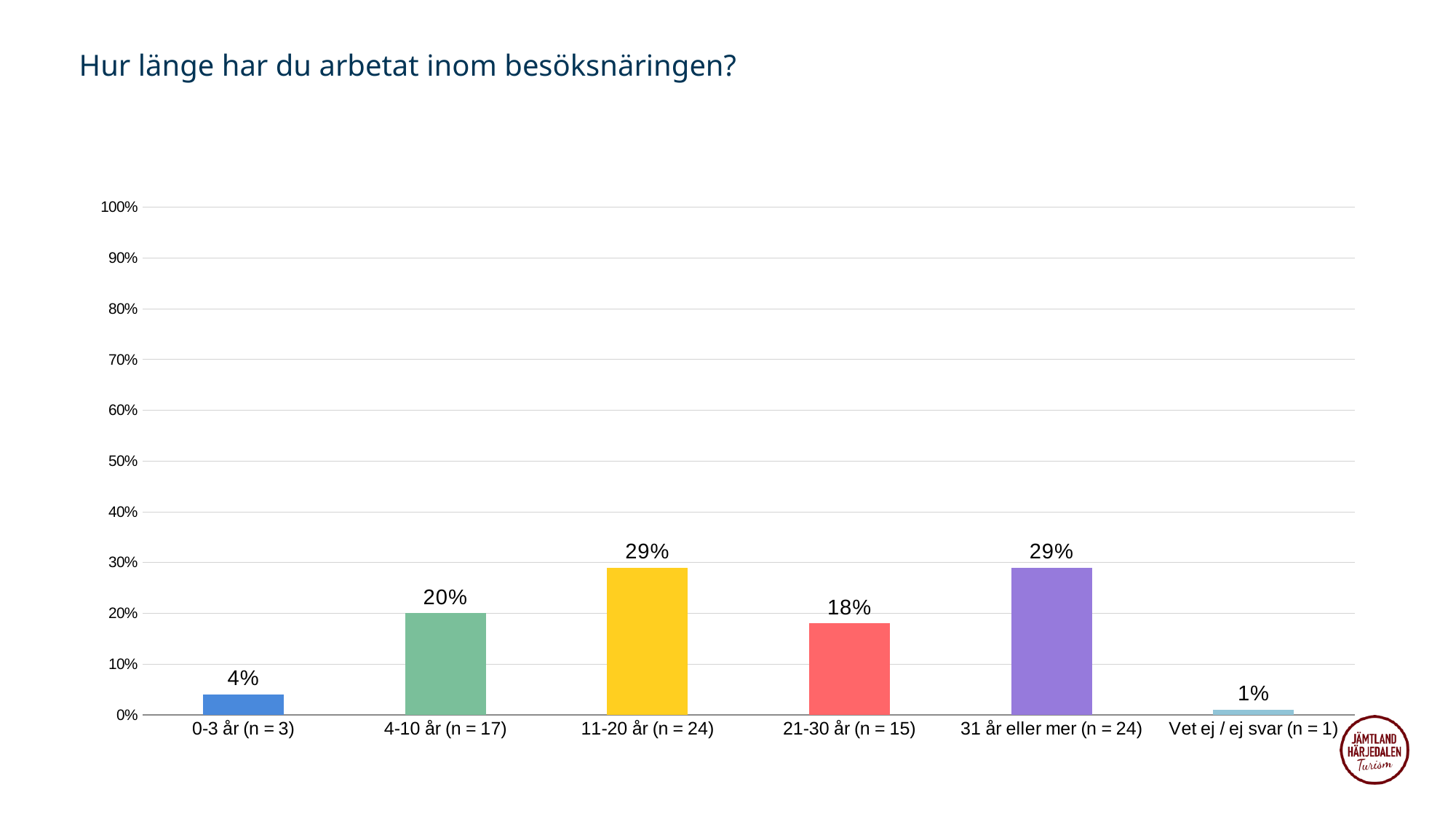
What is the value for the "21-30 år (n = 15)" category? 18% Is the value for "31 år eller mer (n = 24)" greater or less than 20%? greater What is the difference between the values for "4-10 år (n = 17)" and "21-30 år (n = 15)"? 2% Which category has the lowest value? Vet ej / ej svar (n = 1) How many categories are shown on the x axis? 6 What is the value for the "0-3 år (n = 3)" category? 4% What is the value for the "Vet ej / ej svar (n = 1)" category? 1% What is the difference between the values for "11-20 år (n = 24)" and "0-3 år (n = 3)"? 25% What kind of chart is shown on the slide? Bar chart Which is larger, the value for "4-10 år (n = 17)" or the value for "21-30 år (n = 15)"? 4-10 år (n = 17) What is the title of the chart? Hur länge har du arbetat inom besöksnäringen? What is the value for the "4-10 år (n = 17)" category? 20%